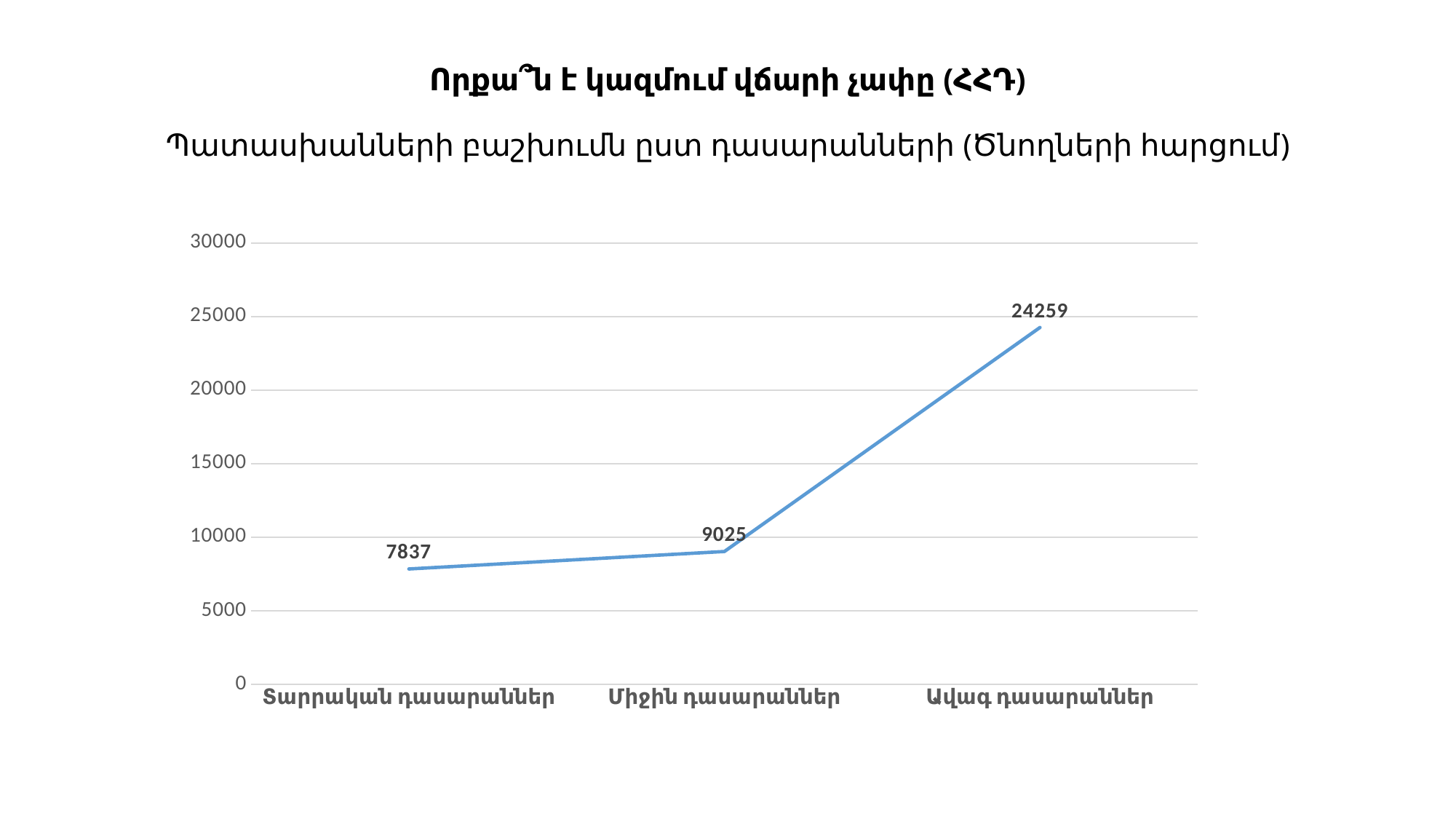
What kind of chart is shown on the slide? line chart Is the value for Ավագ դասարաններ greater or less than 20000? greater How many categories are shown on the x axis? 3 What is the value for Տարրական դասարաններ? 7837 What is the difference between the values for Միջին դասարաններ and Տարրական դասարաններ? 1188 What is the value for Միջին դասարաններ? 9025 Do the values rise or fall from left to right along the x axis? rise Which category has the lowest value? Տարրական դասարաններ Which is larger, the value for Միջին դասարաններ or the value for Տարրական դասարաններ? Միջին դասարաններ What is the difference between the values for Ավագ դասարաններ and Միջին դասարաններ? 15234 What is the value for Ավագ դասարաններ? 24259 Which category has the highest value? Ավագ դասարաններ